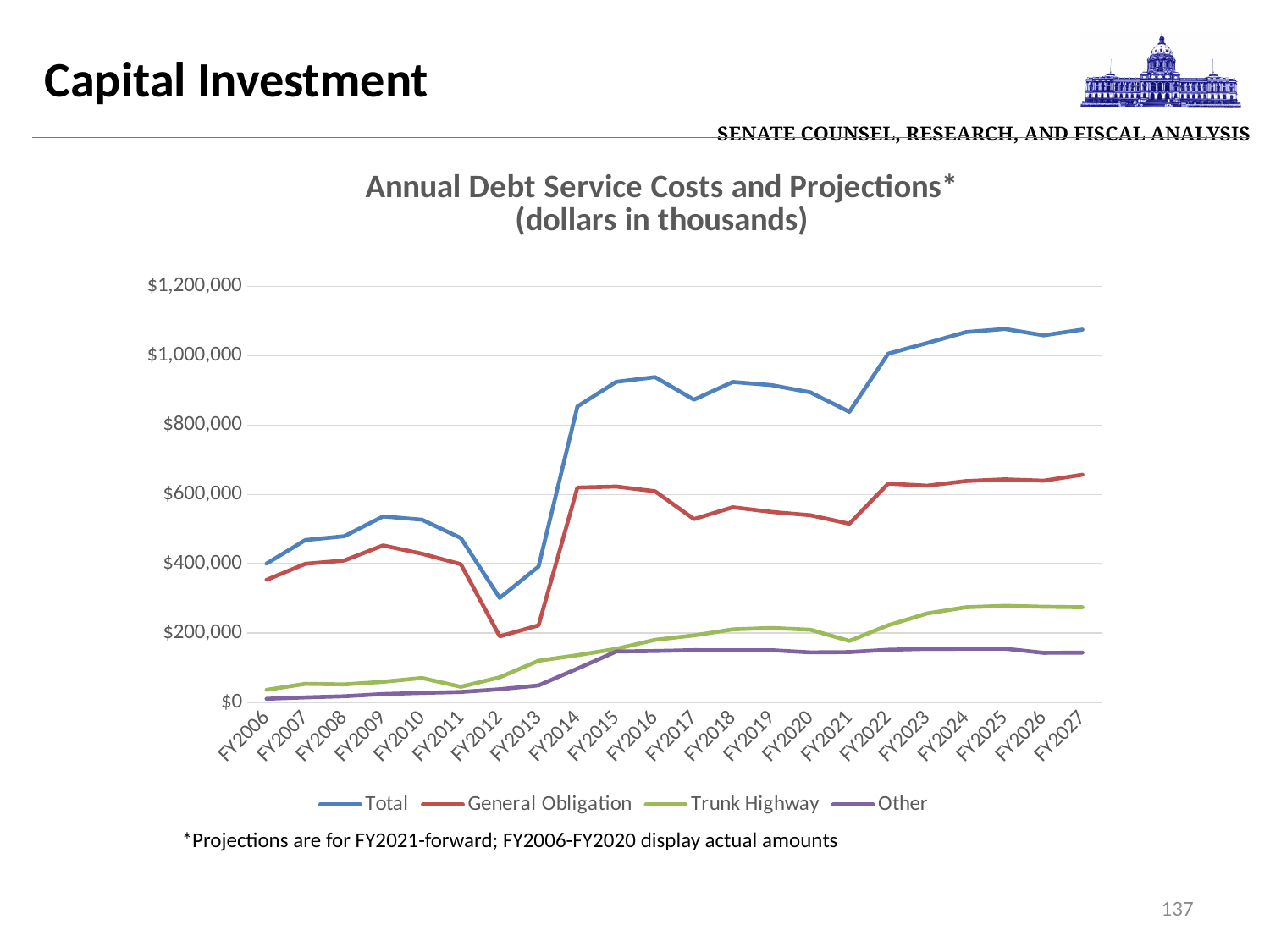
In which fiscal year is the Total series at its lowest? FY2012 In FY2020, which is larger: General Obligation or Trunk Highway? General Obligation How many series does the legend list? 4 Which series are listed in the legend? Total, General Obligation, Trunk Highway, Other Does the Total series rise or fall from FY2021 to FY2027? rise Is the value for Trunk Highway in FY2025 greater or less than $200,000? greater In which fiscal year is the General Obligation series at its lowest? FY2012 Is the value for Total in FY2012 greater or less than $400,000? less What is the title of the chart? Annual Debt Service Costs and Projections* (dollars in thousands) How many fiscal years are plotted along the x axis? 22 Is the value for Total in FY2027 greater or less than $1,000,000? greater What kind of chart is shown on the slide? line chart